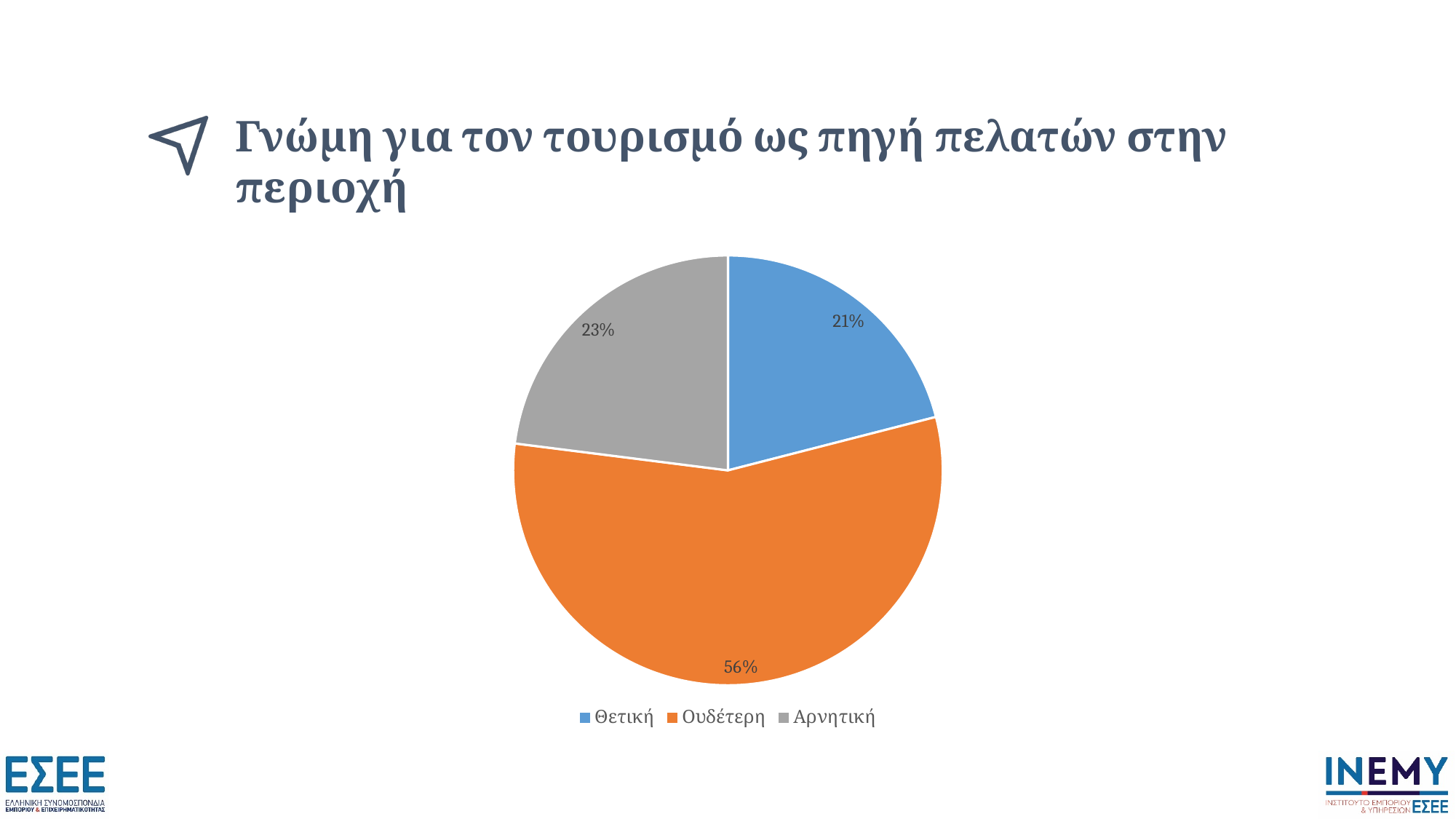
What percentage of the pie is labelled Θετική? 21% Which slice is larger, Θετική or Ουδέτερη? Ουδέτερη How many slices does the pie chart have? 3 What is the difference in percentage points between the Ουδέτερη and Αρνητική slices? 33 What percentage of the pie is labelled Ουδέτερη? 56% What percentage of the pie is labelled Αρνητική? 23% What is the title of the slide? Γνώμη για τον τουρισμό ως πηγή πελατών στην περιοχή What kind of chart is shown on the slide? Pie chart Which category has the largest slice of the pie? Ουδέτερη What is the difference in percentage points between the Αρνητική and Θετική slices? 2 Which category has the smallest slice of the pie? Θετική What colour is the Ουδέτερη slice? Orange